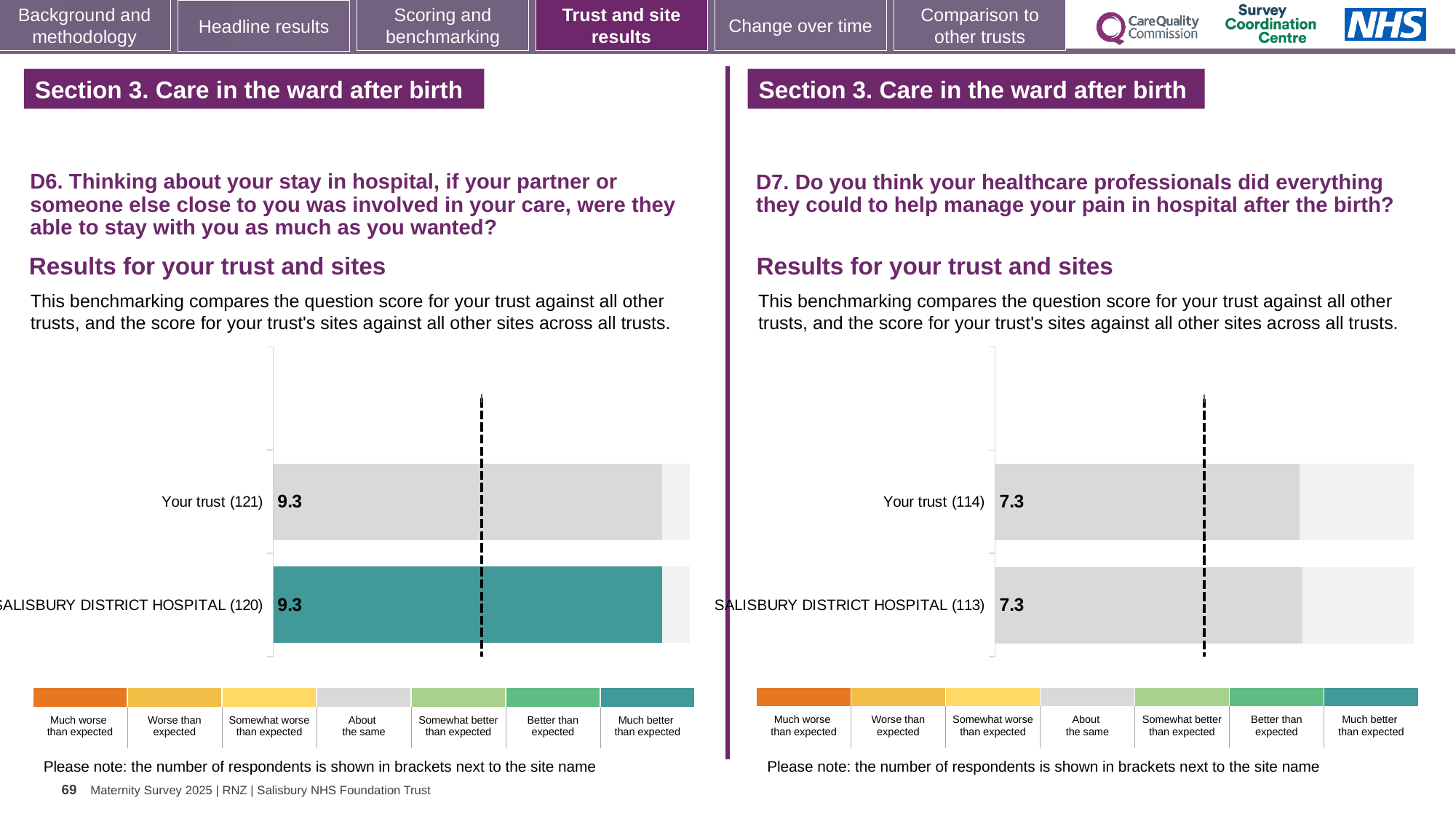
What type of chart is used for the D6 results on the left? Bar chart In the D7 chart on the right, what is the score for SALISBURY DISTRICT HOSPITAL? 7.3 How many bars are plotted in the D6 chart on the left? 2 How many bars are plotted in the D7 chart on the right? 2 In the D6 chart on the left, which benchmark category does the colour of the SALISBURY DISTRICT HOSPITAL bar correspond to in the legend? Much better than expected In the D6 chart on the left, what is the score for SALISBURY DISTRICT HOSPITAL? 9.3 In the D7 chart on the right, what is the score for Your trust? 7.3 In the D6 chart on the left, what is the score for Your trust? 9.3 In the D6 chart on the left, how many respondents are shown in brackets for SALISBURY DISTRICT HOSPITAL? 120 In the D6 chart on the left, what is the difference between the score for Your trust and the score for SALISBURY DISTRICT HOSPITAL? 0.0 In the D7 chart on the right, what is the difference between the score for Your trust and the score for SALISBURY DISTRICT HOSPITAL? 0.0 In the D7 chart on the right, how many respondents are shown in brackets for Your trust? 114